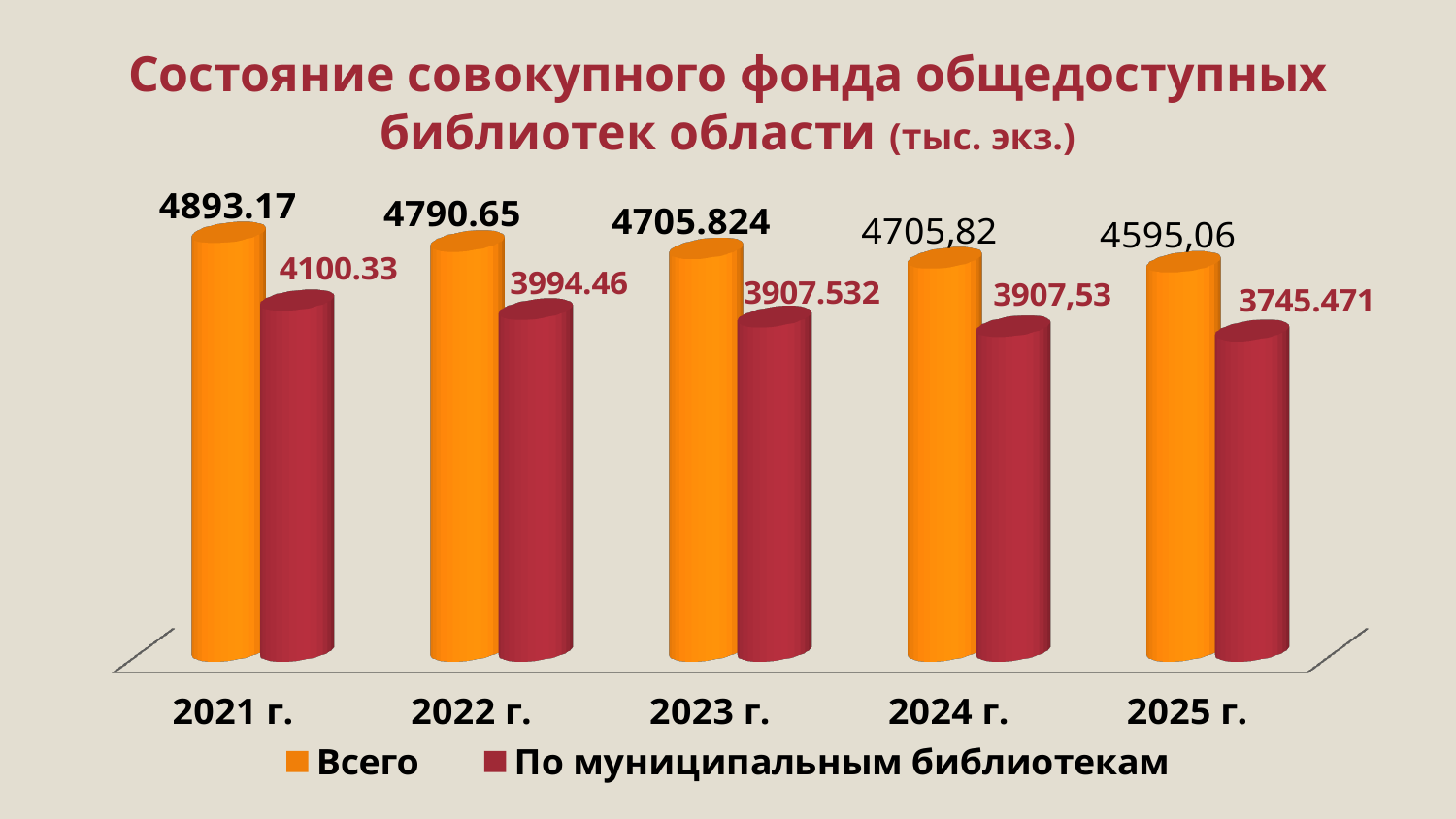
In which year is the "Всего" value highest? 2021 г. What is the value for "По муниципальным библиотекам" in 2022 г.? 3994.46 What is the value for "По муниципальным библиотекам" in 2023 г.? 3907.532 How many years are shown on the x axis? 5 How many series does the legend list? 2 Which is larger: "Всего" in 2022 г. or "Всего" in 2024 г.? Всего in 2022 г. In which year is the "По муниципальным библиотекам" value lowest? 2025 г. What is the difference between "Всего" and "По муниципальным библиотекам" in 2021 г.? 792.84 Do the "Всего" values rise or fall from 2021 г. to 2025 г.? Fall What kind of chart is shown on the slide? Bar chart What is the value for "Всего" in 2025 г.? 4595,06 What is the value for "Всего" in 2021 г.? 4893.17